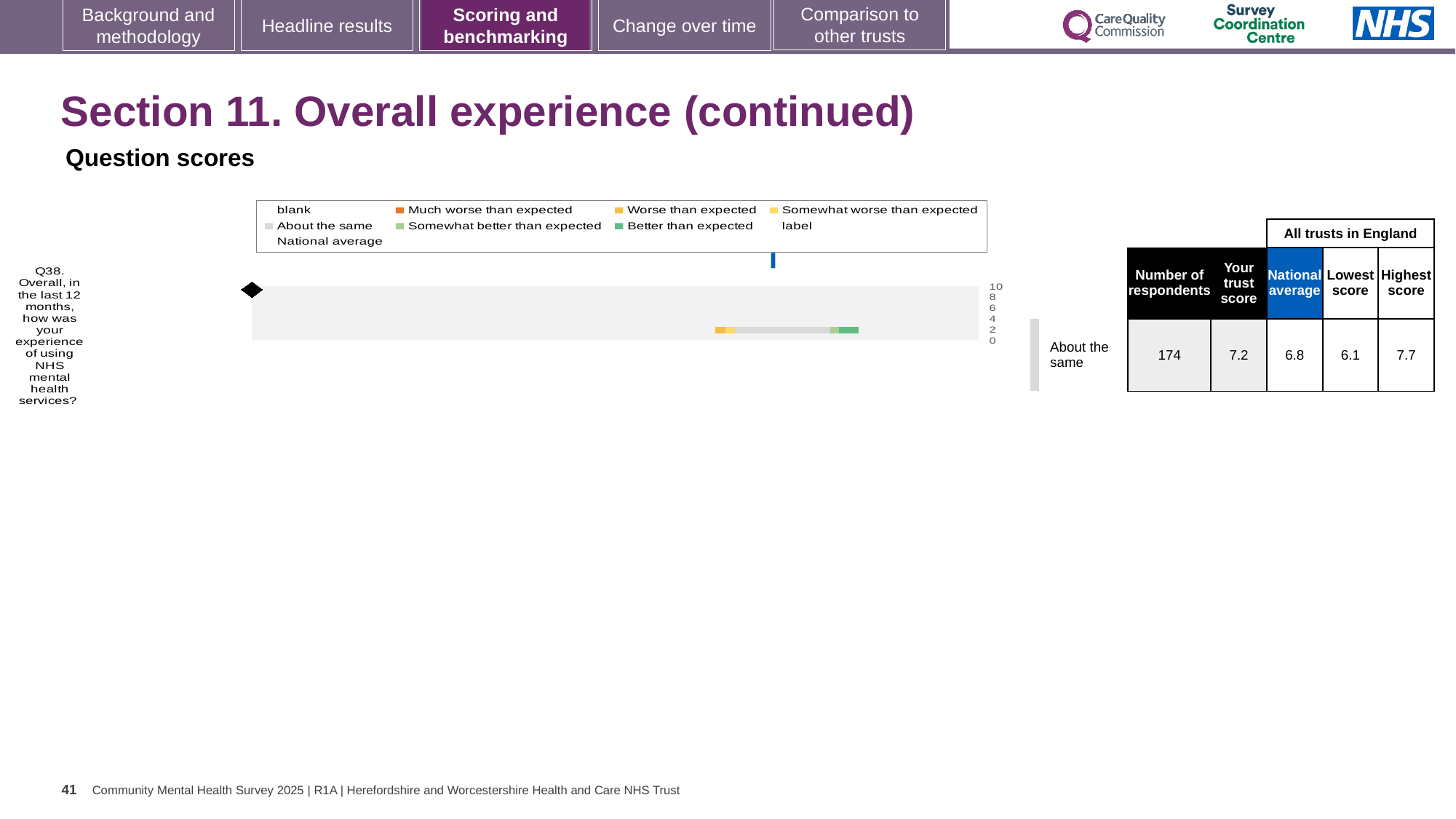
How many survey questions are plotted on the chart? 1 What type of chart is used to show the Q38 question score? bar chart What is the highest value shown on the chart's score axis? 10 What is the difference between the highest and lowest scores among all trusts in England for Q38? 1.6 What is the trust's score for Q38? 7.2 What is the national average score for Q38? 6.8 What is the lowest score among all trusts in England for Q38? 6.1 What is the difference between the trust's score and the national average for Q38? 0.4 Is the trust's score for Q38 higher or lower than the national average? higher Which question is plotted on the chart? Q38. Overall, in the last 12 months, how was your experience of using NHS mental health services? How many respondents answered Q38? 174 What is the highest score among all trusts in England for Q38? 7.7